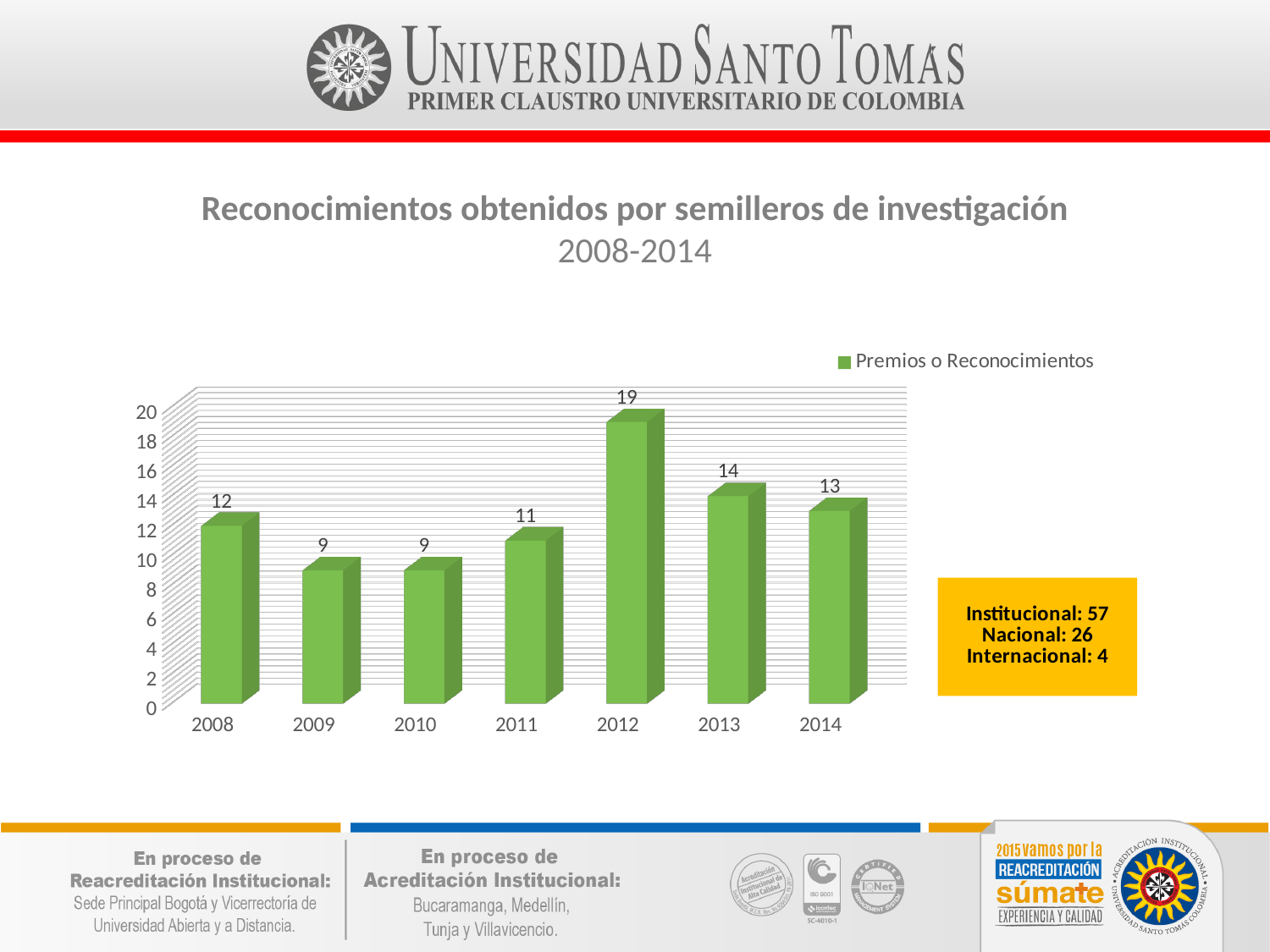
How many years are shown on the x axis? 7 What is the value for 2014? 13 Which year has the highest value? 2012 What kind of chart is shown? bar chart What is the difference between the values for 2012 and 2013? 5 What is the difference between the values for 2008 and 2009? 3 How many series does the legend list? 1 What is the value for 2008? 12 What is the name of the series in the legend? Premios o Reconocimientos Do the values rise or fall from 2010 to 2012? rise What is the value for 2012? 19 Which is larger, the value for 2011 or the value for 2014? 2014